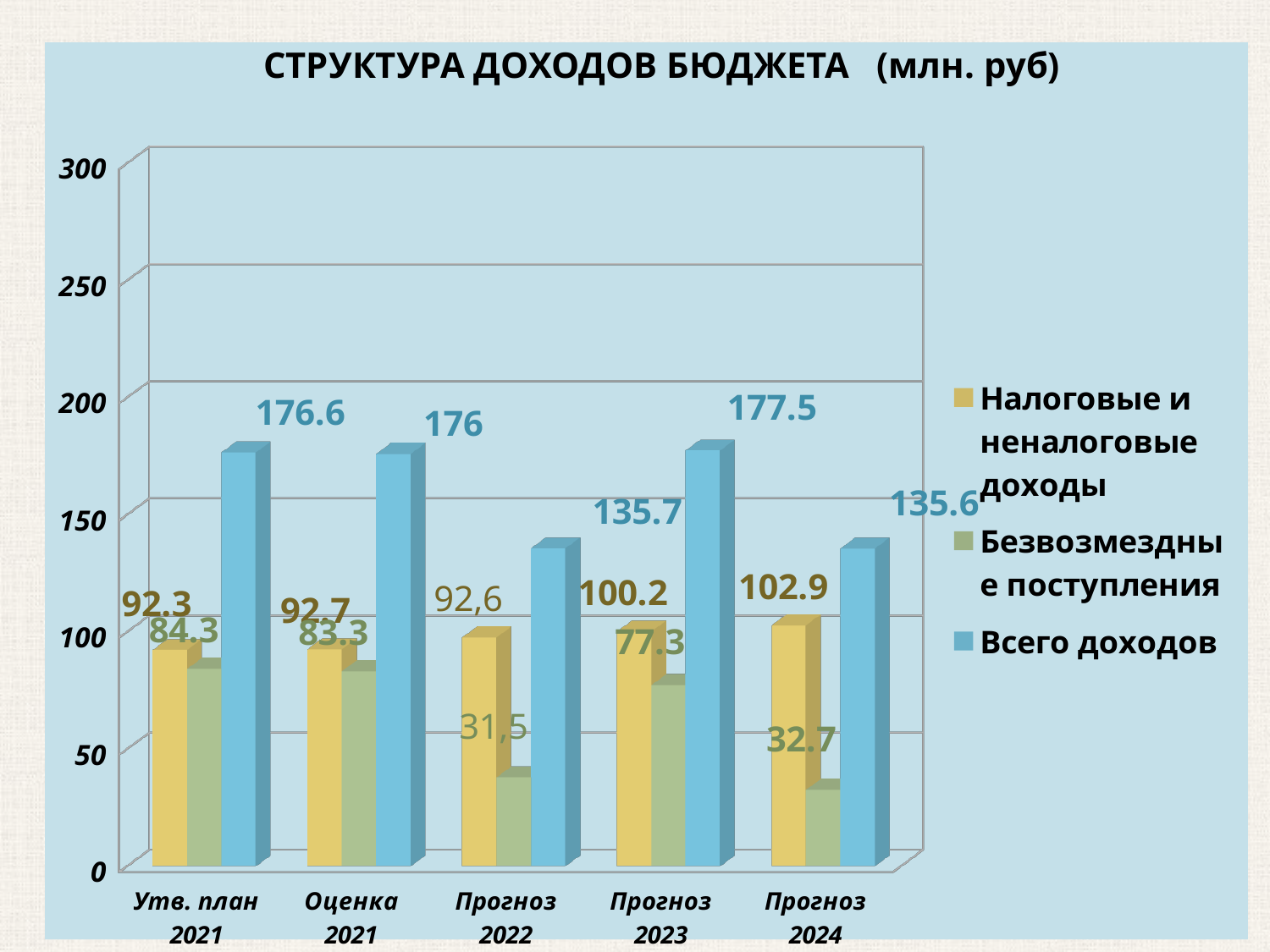
How many categories are shown on the x axis? 5 What type of chart is shown on the slide? bar chart What is the title of the chart? СТРУКТУРА ДОХОДОВ БЮДЖЕТА (млн. руб) What is the value of Безвозмездные поступления for Прогноз 2022? 31,5 Which category has the lowest value of Безвозмездные поступления? Прогноз 2022 How many series does the legend list? 3 What is the value of Всего доходов for Утв. план 2021? 176.6 What is the value of Безвозмездные поступления for Прогноз 2023? 77.3 Which is larger: Налоговые и неналоговые доходы for Прогноз 2023 or for Оценка 2021? Прогноз 2023 What is the value of Налоговые и неналоговые доходы for Прогноз 2024? 102.9 Which category has the highest value of Всего доходов? Прогноз 2023 What is the difference between Всего доходов for Прогноз 2023 and Прогноз 2024? 41.9